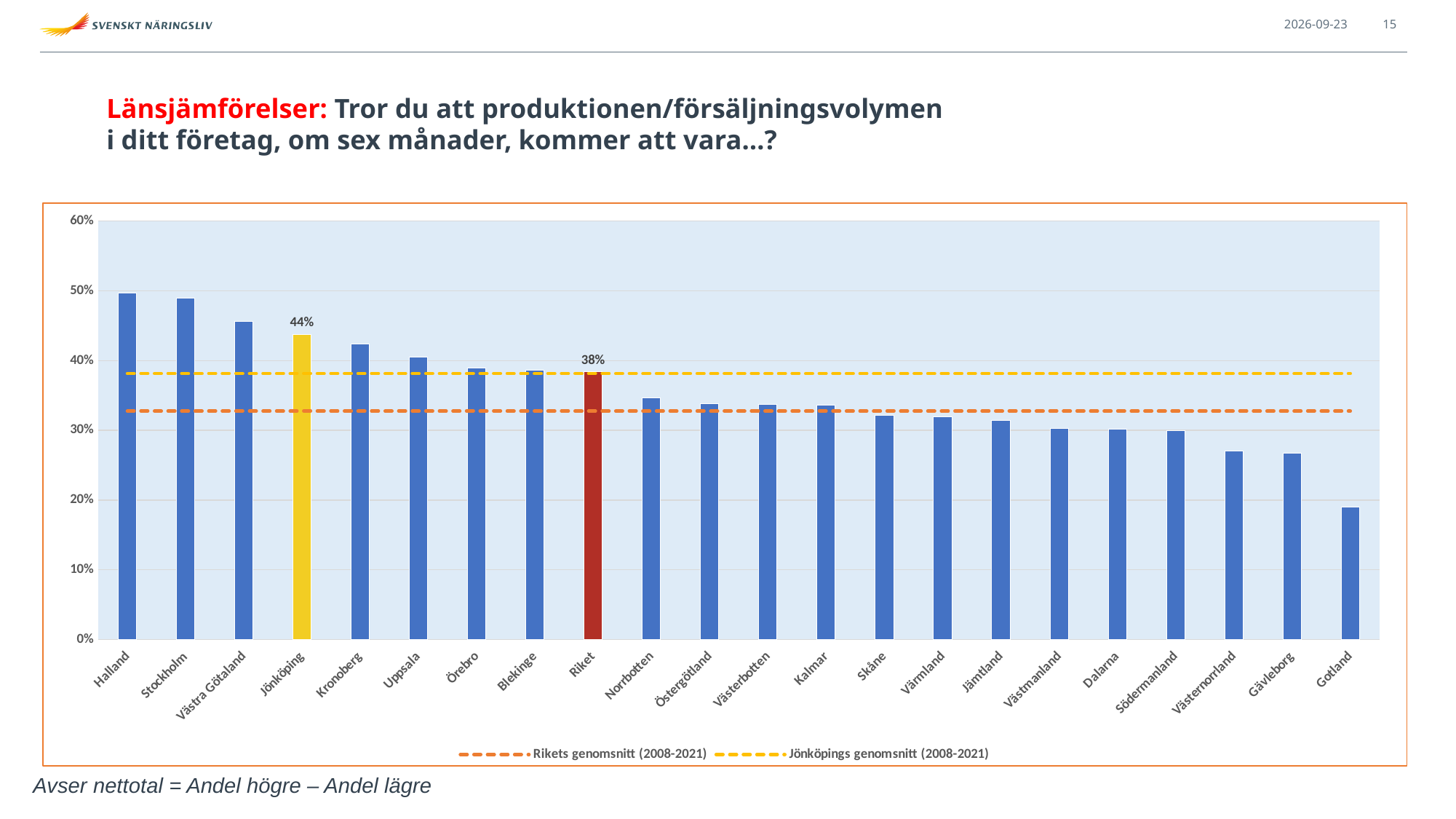
How many bars (categories) are shown in the chart? 22 Do the bar values rise or fall from left to right along the x axis? Fall What kind of chart is shown on the slide? Bar chart Is the value for Gotland greater or less than 30%? less Is the value for Gävleborg greater or less than 30%? less Which county has the lowest bar in the chart? Gotland What is the value shown for Jönköping? 44% Is the value for Halland greater or less than 40%? greater Which county has the highest bar in the chart? Halland What is the difference between the labelled values for Jönköping and Riket? 6 percentage points What is the value shown for Riket? 38% Which is larger, the value for Jönköping or the value for Riket? Jönköping